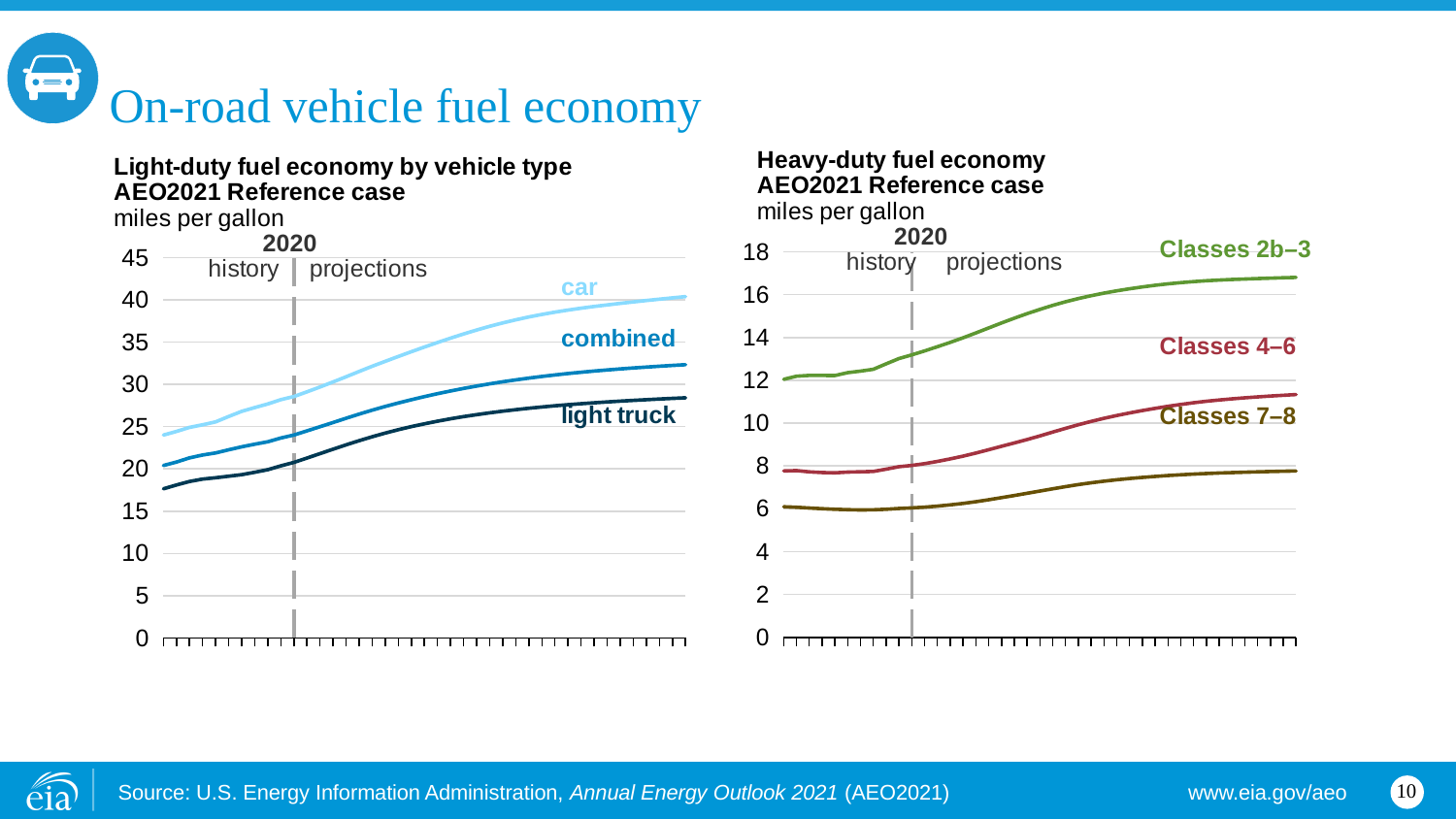
What unit is used on the y axis of both charts? miles per gallon On the 'Heavy-duty fuel economy' chart, which is larger at the end of the projections: Classes 4–6 or Classes 7–8? Classes 4–6 On the 'Light-duty fuel economy by vehicle type' chart, is the light truck value at the end of the projections greater or less than 30 miles per gallon? less On the 'Heavy-duty fuel economy' chart, is the Classes 4–6 value at the end of the projections greater or less than 10 miles per gallon? greater On the 'Heavy-duty fuel economy' chart, which class group has the highest fuel economy? Classes 2b–3 On the 'Light-duty fuel economy by vehicle type' chart, which vehicle type has the highest fuel economy at the end of the projection period? car What kind of chart is the 'Light-duty fuel economy by vehicle type' chart? line chart On the 'Light-duty fuel economy by vehicle type' chart, which vehicle type has the lowest fuel economy throughout the period? light truck How many series are plotted on the 'Heavy-duty fuel economy' chart? 3 How many series are plotted on the 'Light-duty fuel economy by vehicle type' chart? 3 On the 'Light-duty fuel economy by vehicle type' chart, is the car value at the end of the projections greater or less than 35 miles per gallon? greater On the 'Light-duty fuel economy by vehicle type' chart, do the fuel economy values rise or fall over the projection period? rise